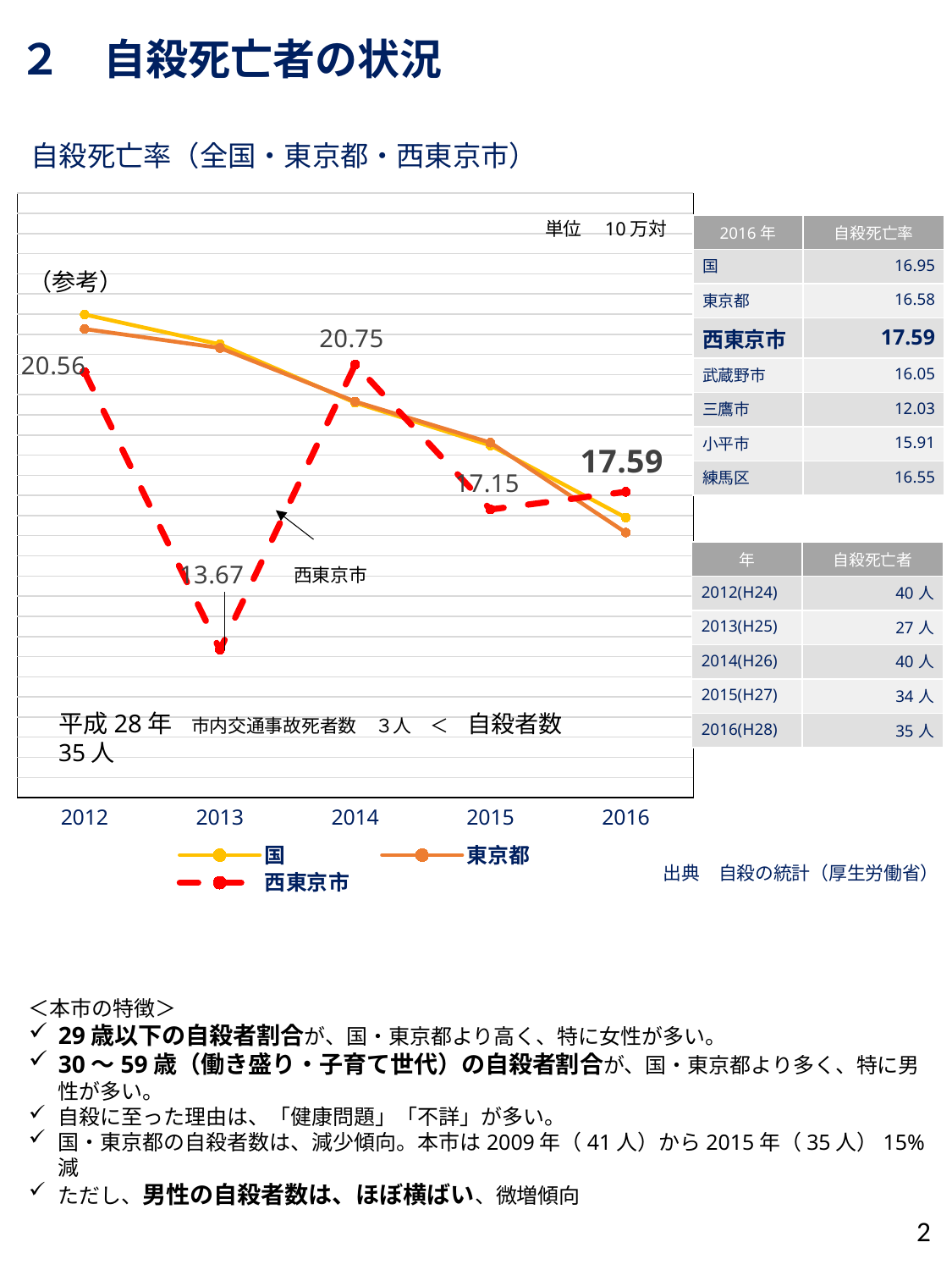
What is the suicide mortality rate for 西東京市 in 2014 according to the chart? 20.75 What unit is stated in the top right of the chart area? 10万対 How many years are plotted along the x axis of the chart? 5 Does the 国 (national) line rise or fall from 2012 to 2016? fall What is the suicide mortality rate for 西東京市 in 2013 according to the chart? 13.67 In which year is the 西東京市 line at its lowest value? 2013 In which year is the 西東京市 line at its highest value? 2014 What kind of chart is shown on the slide? line chart What is the difference between the 西東京市 values for 2014 and 2013? 7.08 Which is larger for 西東京市: the 2012 value or the 2016 value? 2012 What is the suicide mortality rate for 西東京市 in 2016 according to the chart? 17.59 How many series does the chart legend list? 3